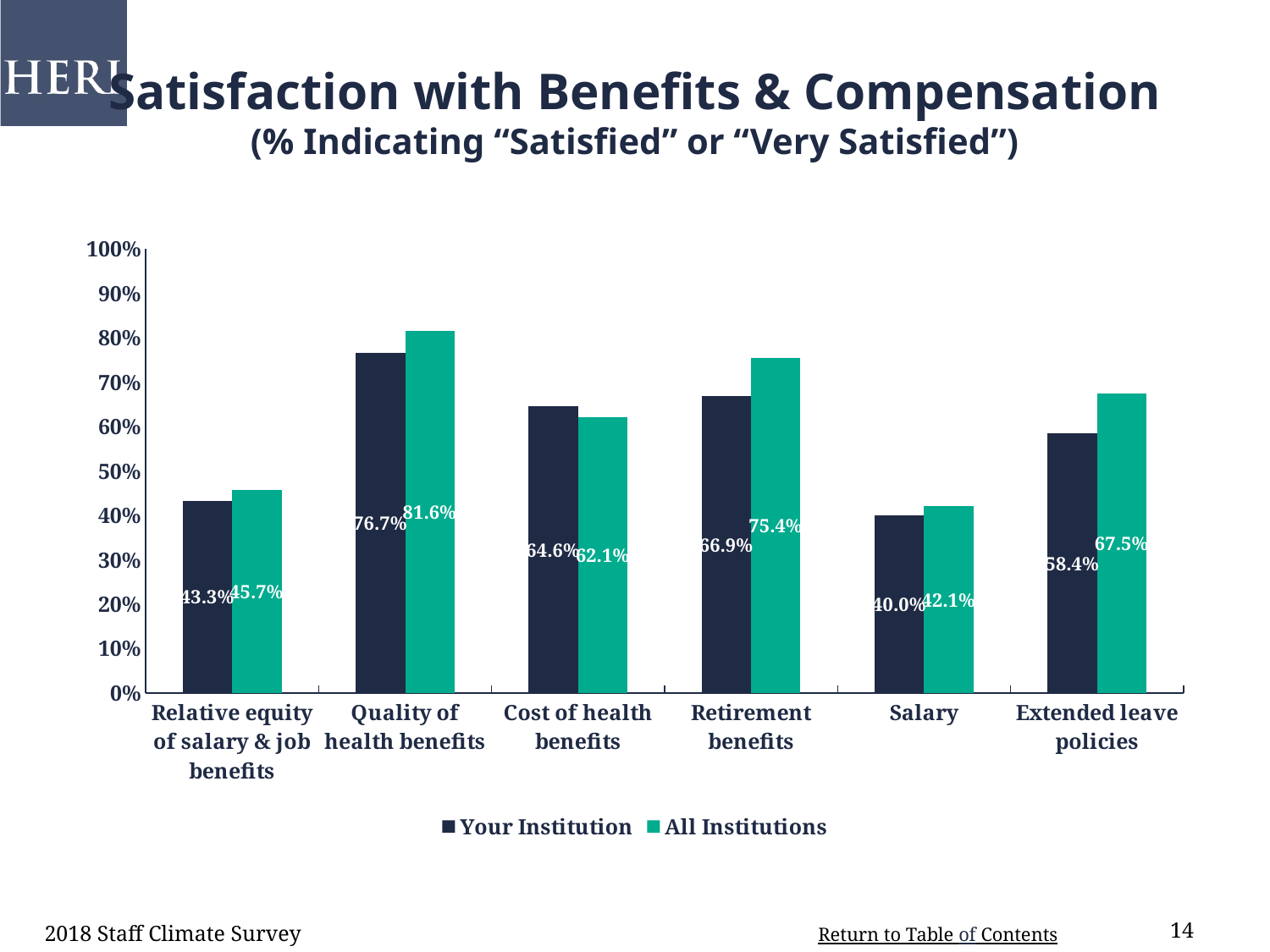
What is the value for Your Institution for Salary? 40.0% For Cost of health benefits, which is larger: Your Institution or All Institutions? Your Institution What kind of chart is shown on the slide? Bar chart How many series does the legend list? 2 What is the value for All Institutions for Retirement benefits? 75.4% Which category has the lowest value for Your Institution? Salary What is the value for Your Institution for Quality of health benefits? 76.7% What is the value for All Institutions for Extended leave policies? 67.5% How many categories are shown on the x axis? 6 Which category has the highest value for All Institutions? Quality of health benefits What is the difference between All Institutions and Your Institution for Retirement benefits? 8.5% Is the value for Your Institution for Extended leave policies greater or less than 50%? greater